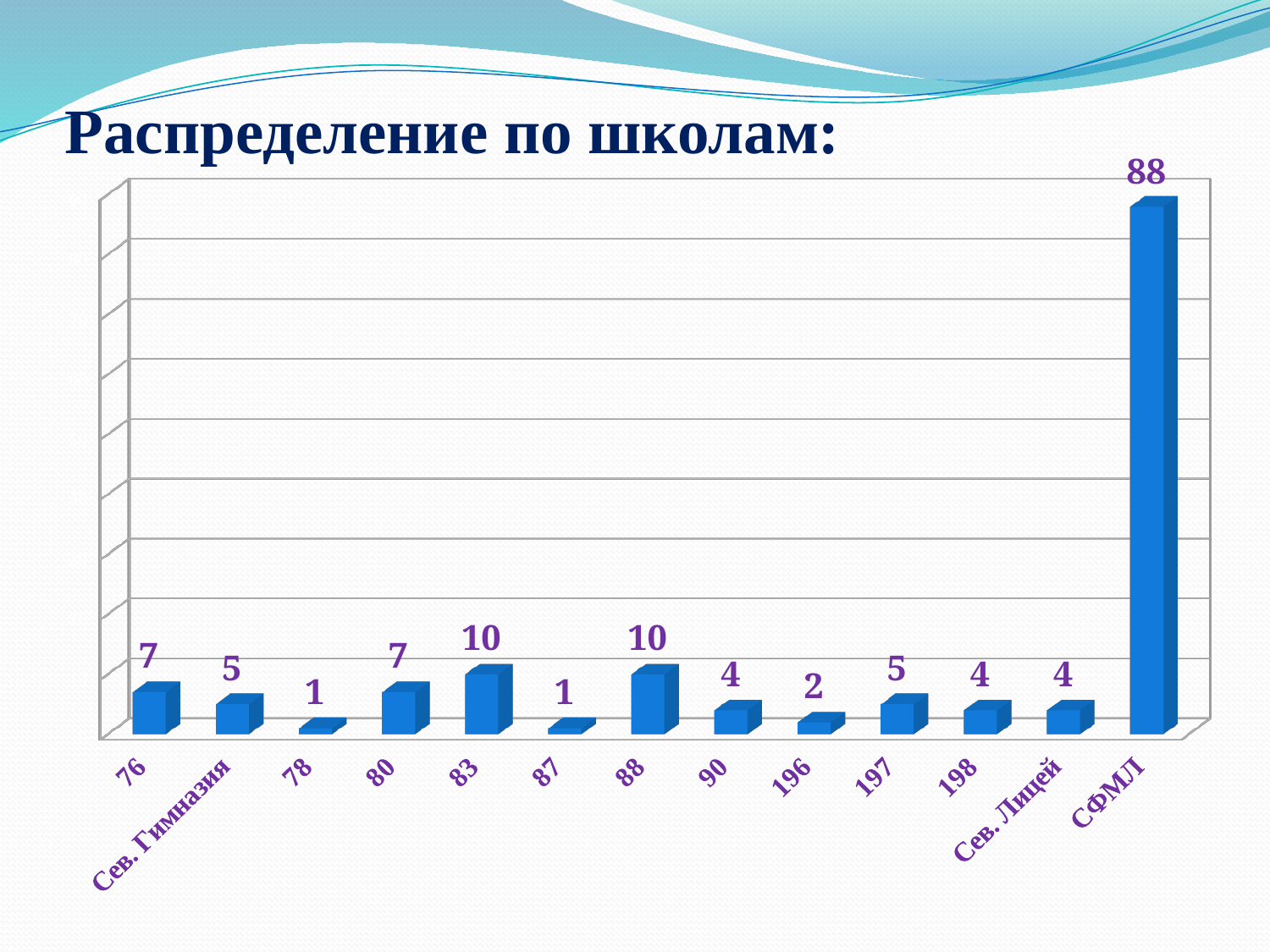
What is the difference between the values for СФМЛ and school 88? 78 What is the value for school 196? 2 Which is larger, the value for school 90 or the value for school 197? 197 What is the value for Сев. Гимназия? 5 What is the title of the slide? Распределение по школам: What is the difference between the values for school 76 and school 78? 6 What is the value for school 83? 10 What is the value for СФМЛ? 88 Which category has the highest value? СФМЛ What kind of chart is shown on the slide? bar chart How many categories are shown on the x axis? 13 Which is larger, the value for school 80 or the value for school 87? 80